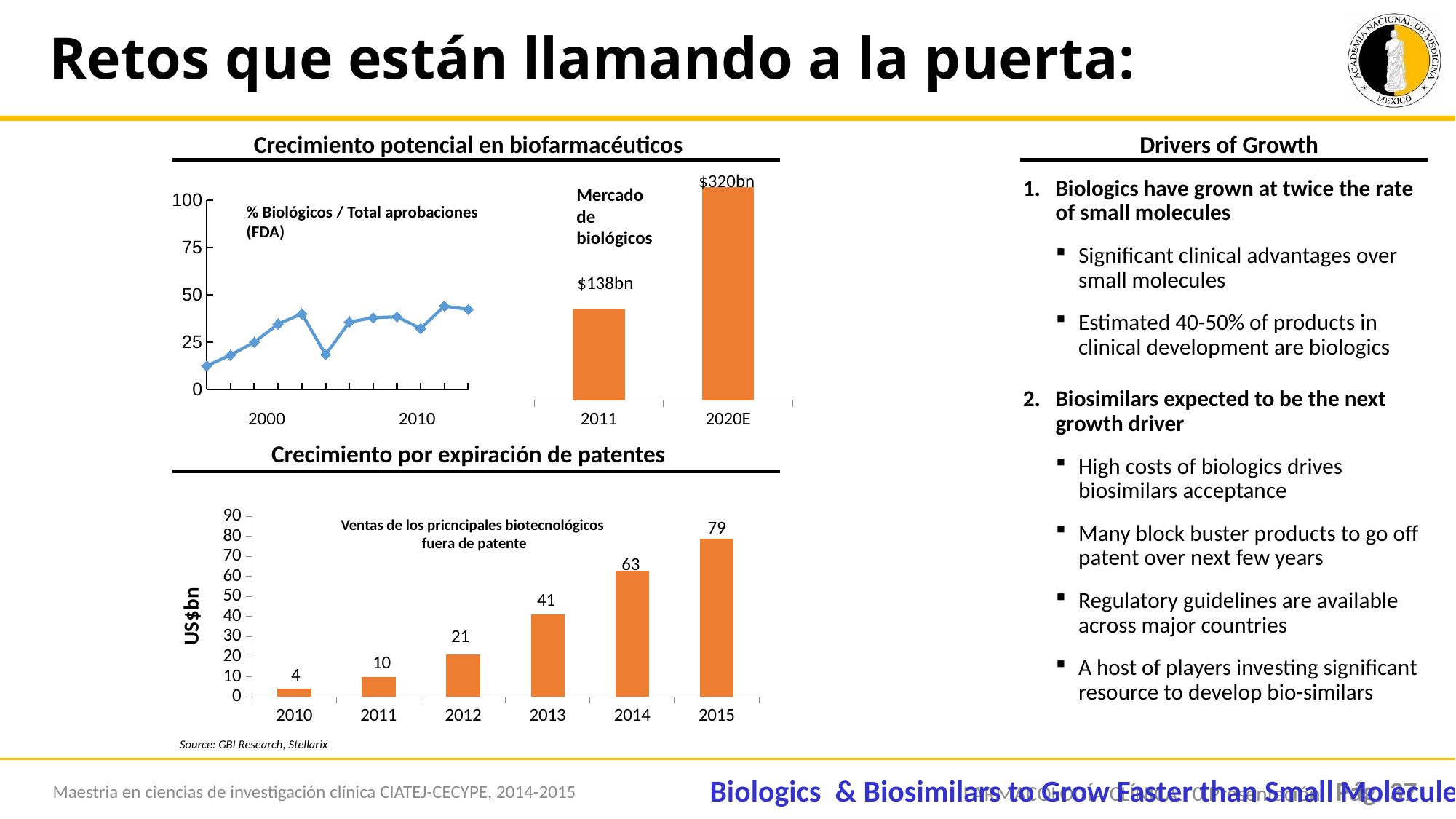
In the 'Ventas de los principales biotecnológicos fuera de patente' chart, what is the difference between the values for 2014 and 2012? 42 In the 'Ventas de los principales biotecnológicos fuera de patente' chart, what is the value for 2015? 79 In the 'Mercado de biológicos' chart, what is the value for 2020E? $320bn In the 'Ventas de los principales biotecnológicos fuera de patente' chart, which year has the lowest value? 2010 In the 'Mercado de biológicos' chart, what is the value for 2011? $138bn What kind of chart is the '% Biológicos / Total aprobaciones (FDA)' chart? line chart What is the y-axis label of the 'Ventas de los principales biotecnológicos fuera de patente' chart? US$bn In the 'Ventas de los principales biotecnológicos fuera de patente' chart, what is the value for 2013? 41 In the 'Ventas de los principales biotecnológicos fuera de patente' chart, do the values rise or fall from 2010 to 2015? rise In the 'Ventas de los principales biotecnológicos fuera de patente' chart, how many years are shown on the x axis? 6 In the 'Mercado de biológicos' chart, which is larger, the value for 2011 or for 2020E? 2020E In the 'Ventas de los principales biotecnológicos fuera de patente' chart, which year has the highest value? 2015